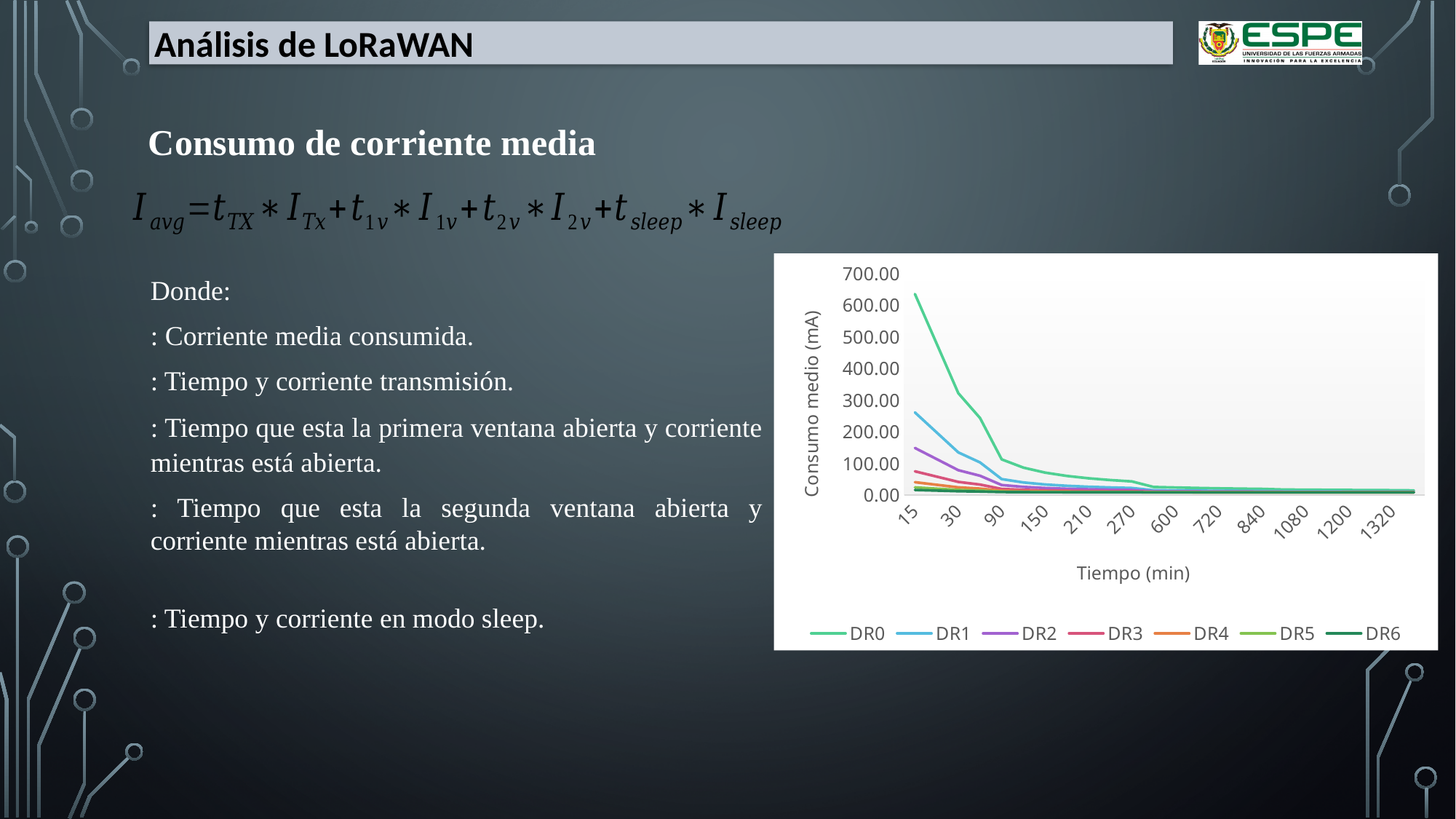
Which series has the lowest value at 15 min? DR6 What kind of chart is shown on the slide? line chart Is the value for DR3 at 15 min greater or less than 100? less Which series has the highest value at 15 min? DR0 Is the value for DR0 at 90 min greater or less than 200? less How many series does the chart legend list? 7 Do the values for DR0 rise or fall as time increases along the x axis? fall Is the value for DR0 at 15 min greater or less than 500? greater How many time values are labelled on the x axis of the chart? 12 What is the title of the chart's y axis? Consumo medio (mA) Which is larger at 30 min, DR1 or DR2? DR1